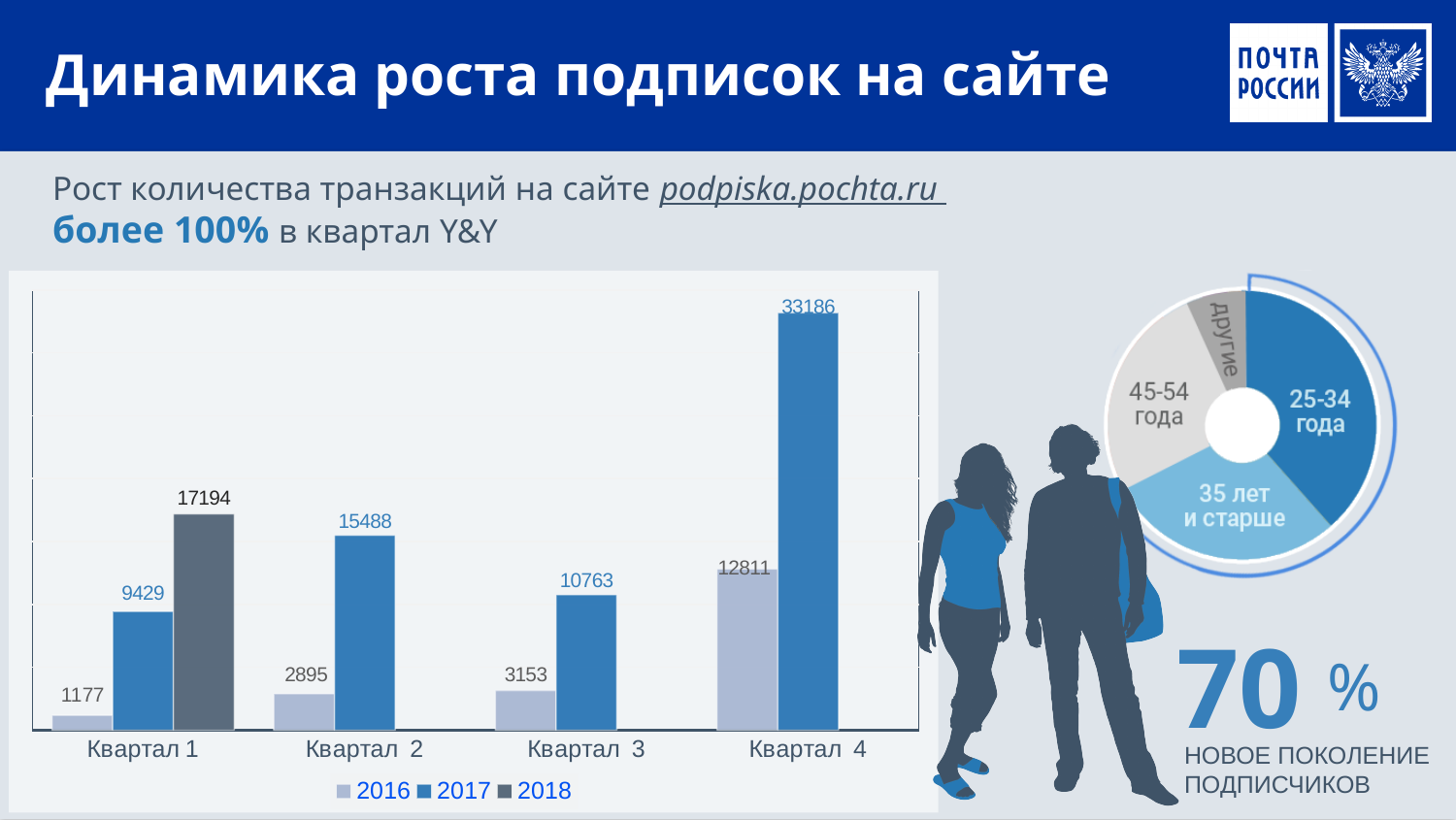
In the bar chart on the left, how many series does the legend list? 3 In the bar chart on the left, what is the value for 2017 in Квартал 3? 10763 In the bar chart on the left, what is the value for 2017 in Квартал 4? 33186 In the bar chart on the left, what is the value for 2016 in Квартал 1? 1177 In the bar chart on the left, which quarter has the lowest value for 2016? Квартал 1 In the bar chart on the left, what is the difference between the 2017 and 2016 values in Квартал 2? 12593 In the bar chart on the left, which is larger in Квартал 1: the 2017 value or the 2018 value? 2018 In the bar chart on the left, what is the value for 2018 in Квартал 1? 17194 In the bar chart on the left, how many quarters are shown on the x axis? 4 What kind of chart is the chart on the left of the slide? Bar chart In the bar chart on the left, which quarter has the highest value for 2017? Квартал 4 In the bar chart on the left, do the 2016 values rise or fall from Квартал 1 to Квартал 4? Rise